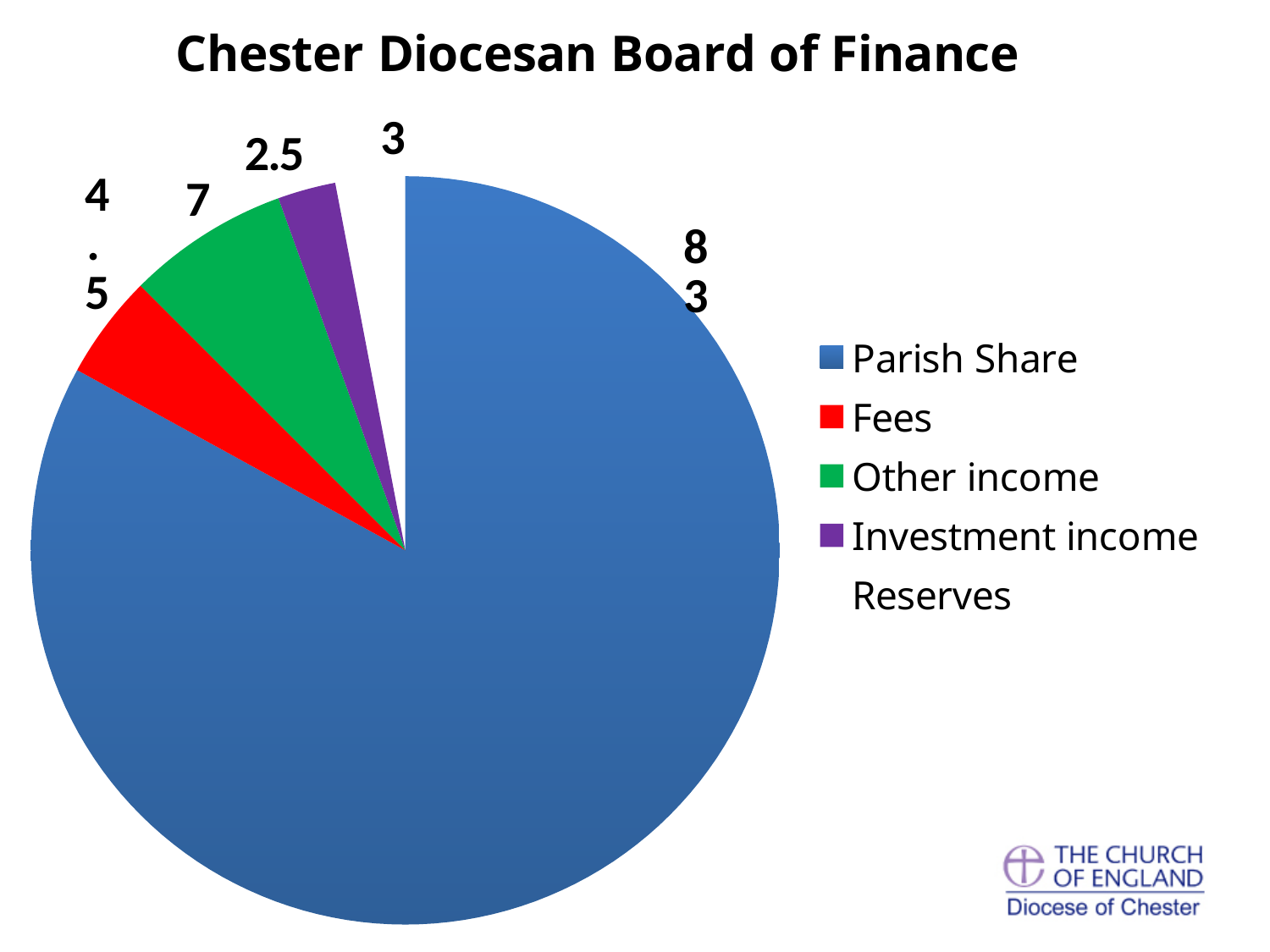
What is the value of the Other income slice? 7 What is the value of the Fees slice? 4.5 What kind of chart is shown on the slide? Pie chart What is the title of the chart? Chester Diocesan Board of Finance Which category has the smallest slice of the pie? Investment income Which category has the largest slice of the pie? Parish Share What is the value of the Reserves slice? 3 Which is larger, Fees or Reserves? Fees How many categories does the pie chart show? 5 What is the difference between the Other income value and the Fees value? 2.5 What is the value of the Investment income slice? 2.5 What is the value of the Parish Share slice? 83